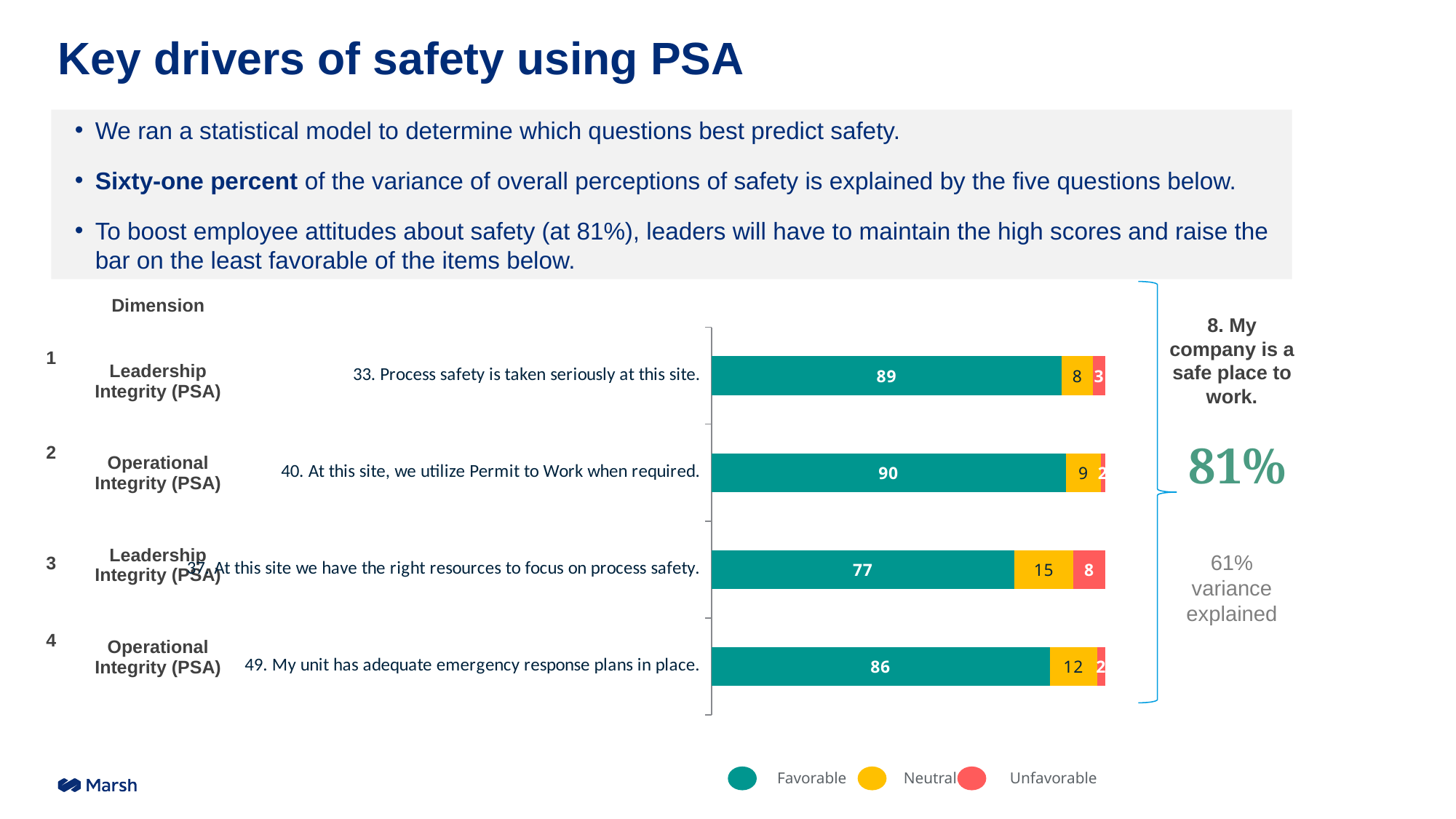
What is the total of the stacked bar for item 37 (Favorable + Neutral + Unfavorable)? 100 What is the Unfavorable value for "40. At this site, we utilize Permit to Work when required."? 2 What is the Favorable value for "33. Process safety is taken seriously at this site."? 89 What kind of chart is shown on the slide? Stacked bar chart What is the Neutral value for "37. At this site we have the right resources to focus on process safety."? 15 How many items (bars) are plotted in the chart? 4 What is the Favorable value for "49. My unit has adequate emergency response plans in place."? 86 Which item has the lowest Favorable value? 37. At this site we have the right resources to focus on process safety. Which has a larger Unfavorable value, item 33 or item 37? 37. At this site we have the right resources to focus on process safety. What is the difference between the Favorable values for item 40 and item 37? 13 How many series does the legend list? 3 Which item has the highest Favorable value? 40. At this site, we utilize Permit to Work when required.